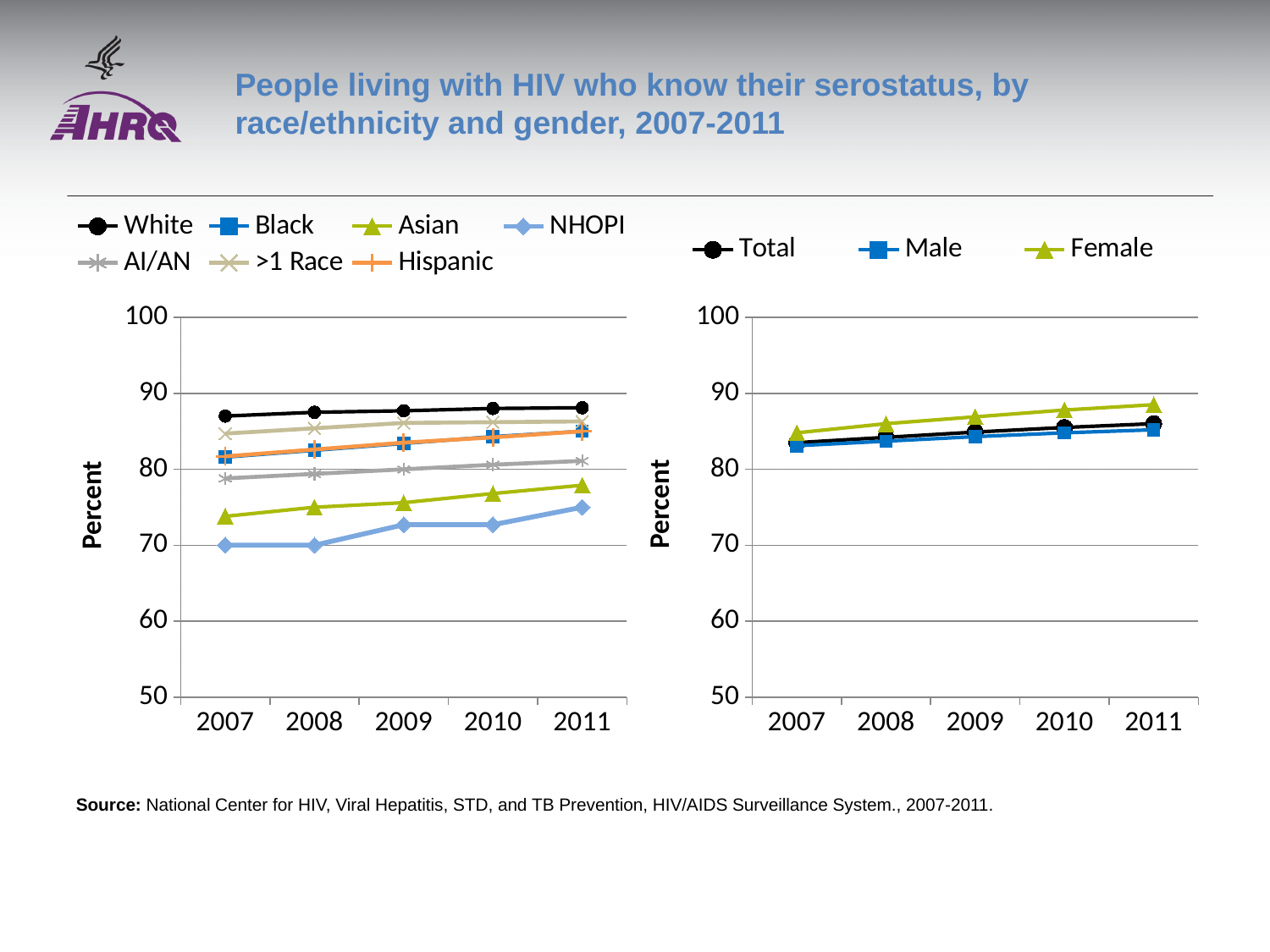
In the left chart (by race/ethnicity), which series has the highest values across all years? White How many years are shown on the x axis of the right chart (by gender)? 5 How many series does the legend of the right chart (by gender) list? 3 In the left chart (by race/ethnicity), is the value for NHOPI in 2007 greater or less than 80? less In the right chart (by gender), which series has the highest value in 2011? Female In the left chart (by race/ethnicity), is the value for White in 2011 greater or less than 80? greater How many series does the legend of the left chart (by race/ethnicity) list? 7 In the right chart (by gender), do the Female values rise or fall from 2007 to 2011? rise What kind of chart is the left chart (by race/ethnicity)? line chart In the left chart (by race/ethnicity), which series has the lowest value in 2007? NHOPI In the right chart (by gender), is the value for Total in 2007 greater or less than 80? greater In the left chart (by race/ethnicity), which is larger in 2011, the value for White or the value for Asian? White